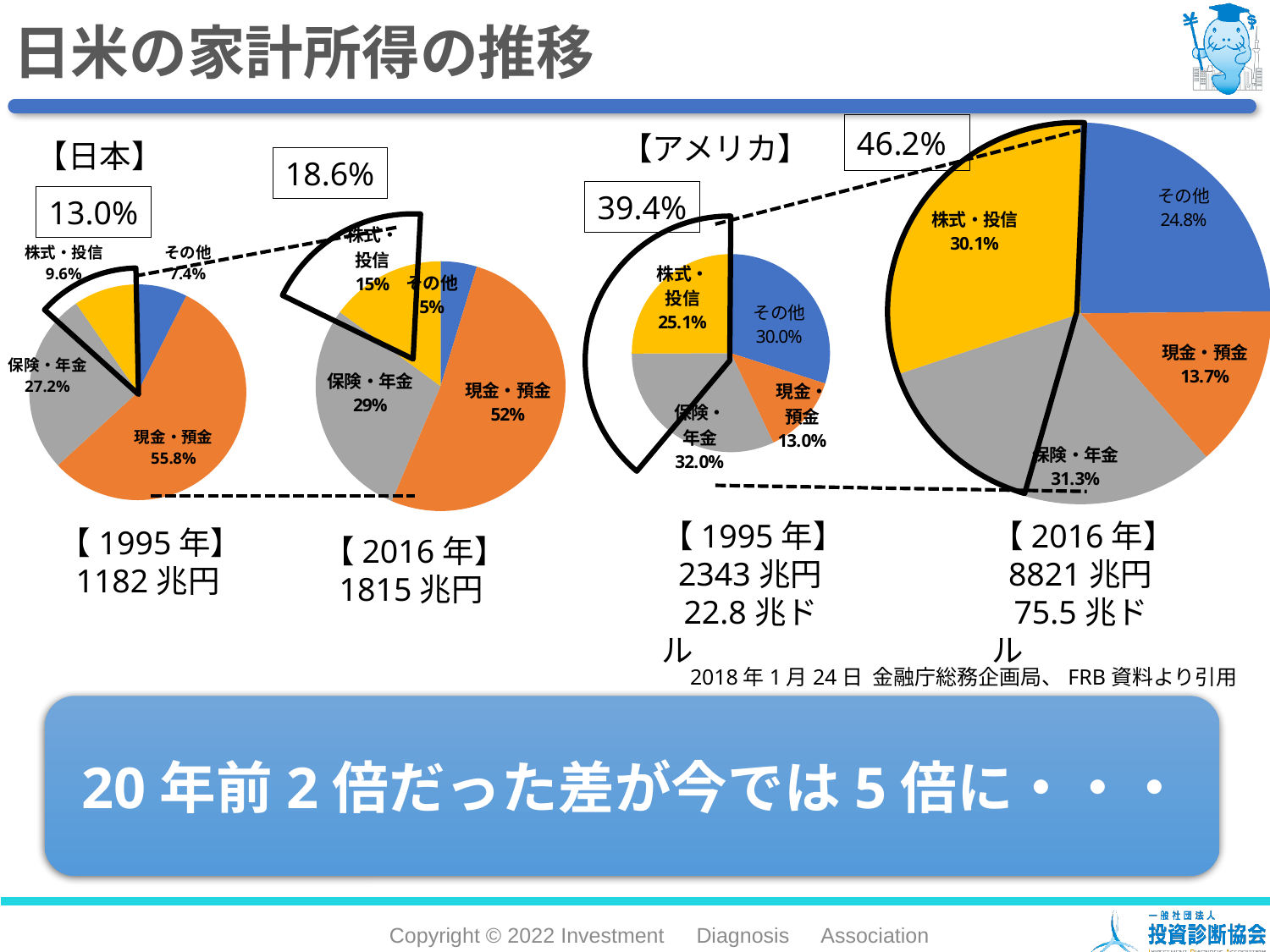
What total amount in 兆円 is shown under the America 2016 pie chart? 8821 兆円 In the Japan 1995 pie chart, what share is 現金・預金? 55.8% In the America 1995 pie chart, what share is 保険・年金? 32.0% In the Japan 2016 pie chart, what share is 株式・投信? 15% What is the difference between the 株式・投信 share in the America 2016 pie chart and the America 1995 pie chart? 5.0% In the America 1995 pie chart, which is larger, 株式・投信 or 現金・預金? 株式・投信 In the America 2016 pie chart, which category has the smallest share? 現金・預金 In the America 2016 pie chart, what share is その他? 24.8% What kind of charts are shown on the slide? Pie charts In the Japan 2016 pie chart, which category has the smallest share? その他 In the Japan 1995 pie chart, which category has the largest share? 現金・預金 How many categories does each pie chart on the slide show? 4